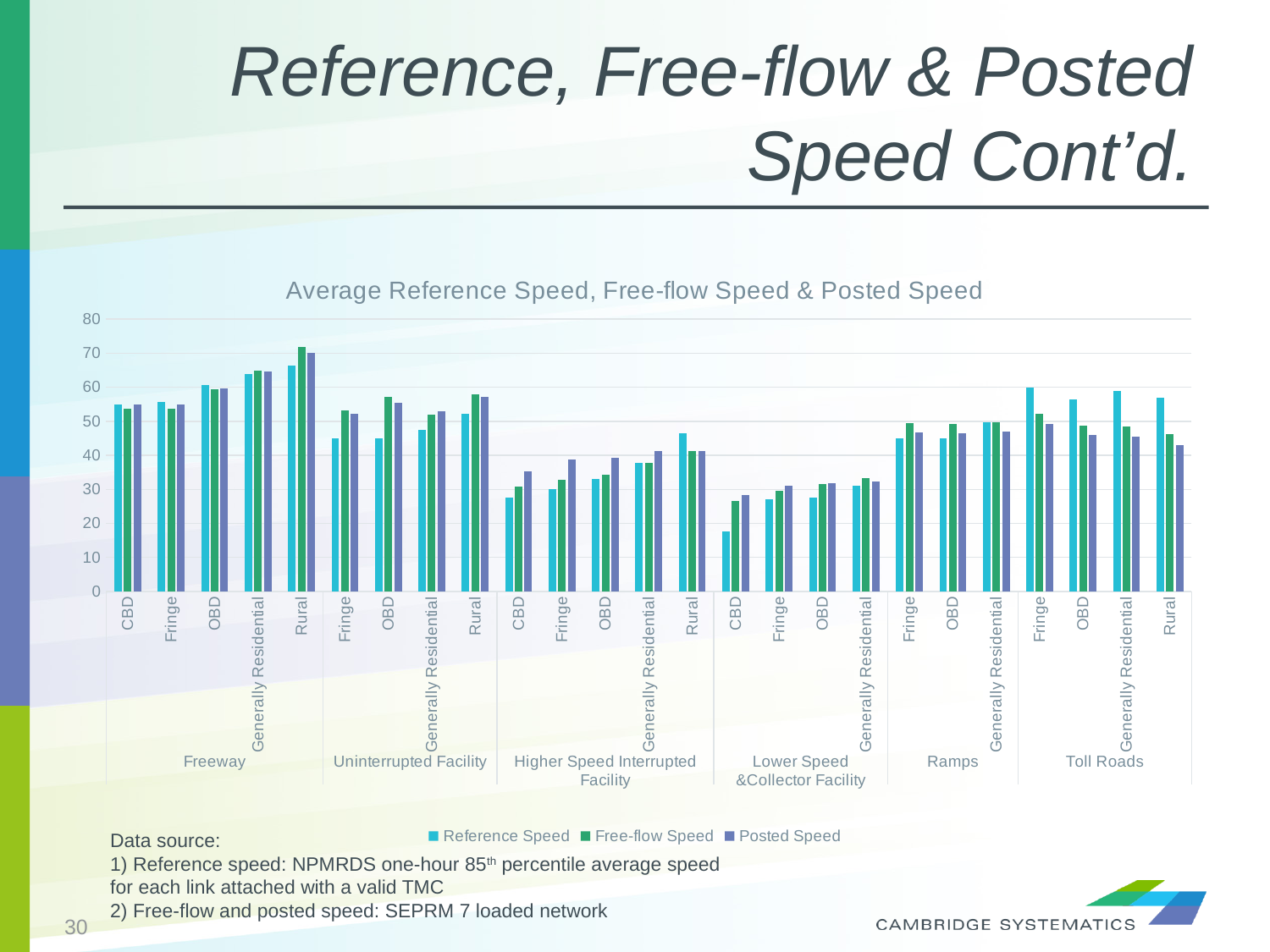
Is the Free-flow Speed for Rural in the Freeway group greater or less than 60? greater For OBD in the Uninterrupted Facility group, which is larger: Reference Speed or Free-flow Speed? Free-flow Speed How many series does the legend list? 3 Is the Reference Speed for CBD in the Lower Speed & Collector Facility group greater or less than 20? less Which bar is the shortest in the whole chart? Reference Speed for CBD in the Lower Speed & Collector Facility group Is the Reference Speed for Fringe in the Toll Roads group greater or less than 50? greater For Fringe in the Toll Roads group, which is larger: Reference Speed or Posted Speed? Reference Speed Which bar is the tallest in the whole chart? Free-flow Speed for Rural in the Freeway group How many facility type groups are shown along the x axis? 6 What is the title of the chart? Average Reference Speed, Free-flow Speed & Posted Speed What kind of chart is shown on the slide? Bar chart How many area categories are shown within the Freeway group? 5